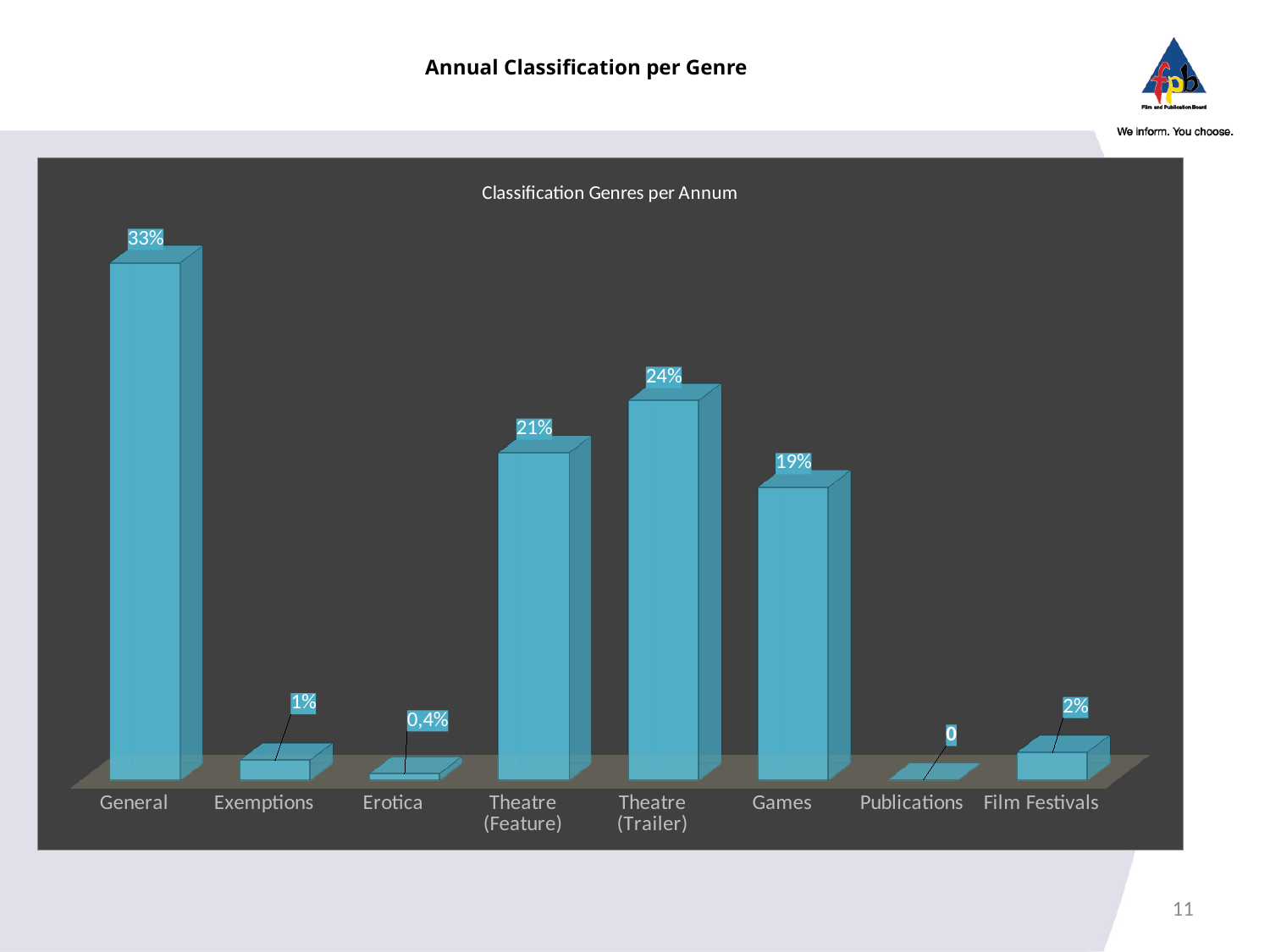
What kind of chart is shown? Bar chart What is the difference between the values for General and Games? 14% What is the difference between the values for Theatre (Trailer) and Theatre (Feature)? 3% How many categories are shown on the x axis? 8 What is the value for Erotica? 0,4% Which is larger, the value for Games or the value for Theatre (Feature)? Theatre (Feature) What is the value for General? 33% What is the value for Publications? 0 What is the value for Theatre (Trailer)? 24% Which category has the highest value? General What is the title shown inside the chart area? Classification Genres per Annum Which category has the lowest value? Publications